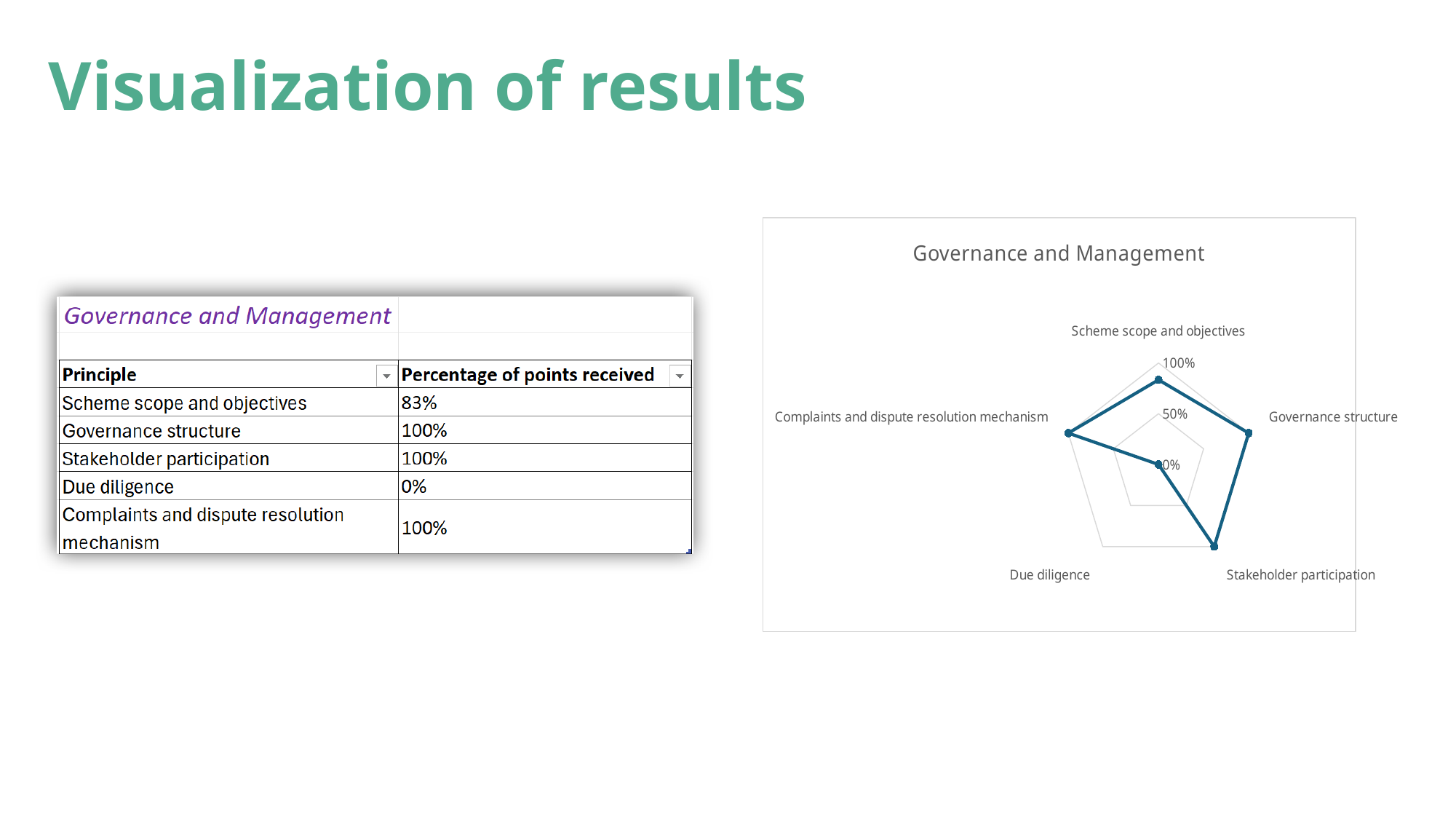
Is the value for Scheme scope and objectives greater or less than 50%? greater How many principles received 100% of points? 3 What kind of chart is shown on the slide? Radar chart What is the percentage of points received for Complaints and dispute resolution mechanism? 100% Which principle has the lowest percentage of points received? Due diligence What is the title of the chart? Governance and Management What is the percentage of points received for Due diligence? 0% What is the percentage of points received for Scheme scope and objectives? 83% Which is larger, the value for Stakeholder participation or the value for Scheme scope and objectives? Stakeholder participation What is the difference between the value for Governance structure and the value for Scheme scope and objectives? 17% What is the percentage of points received for Governance structure? 100% How many principles (categories) are plotted on the radar chart? 5